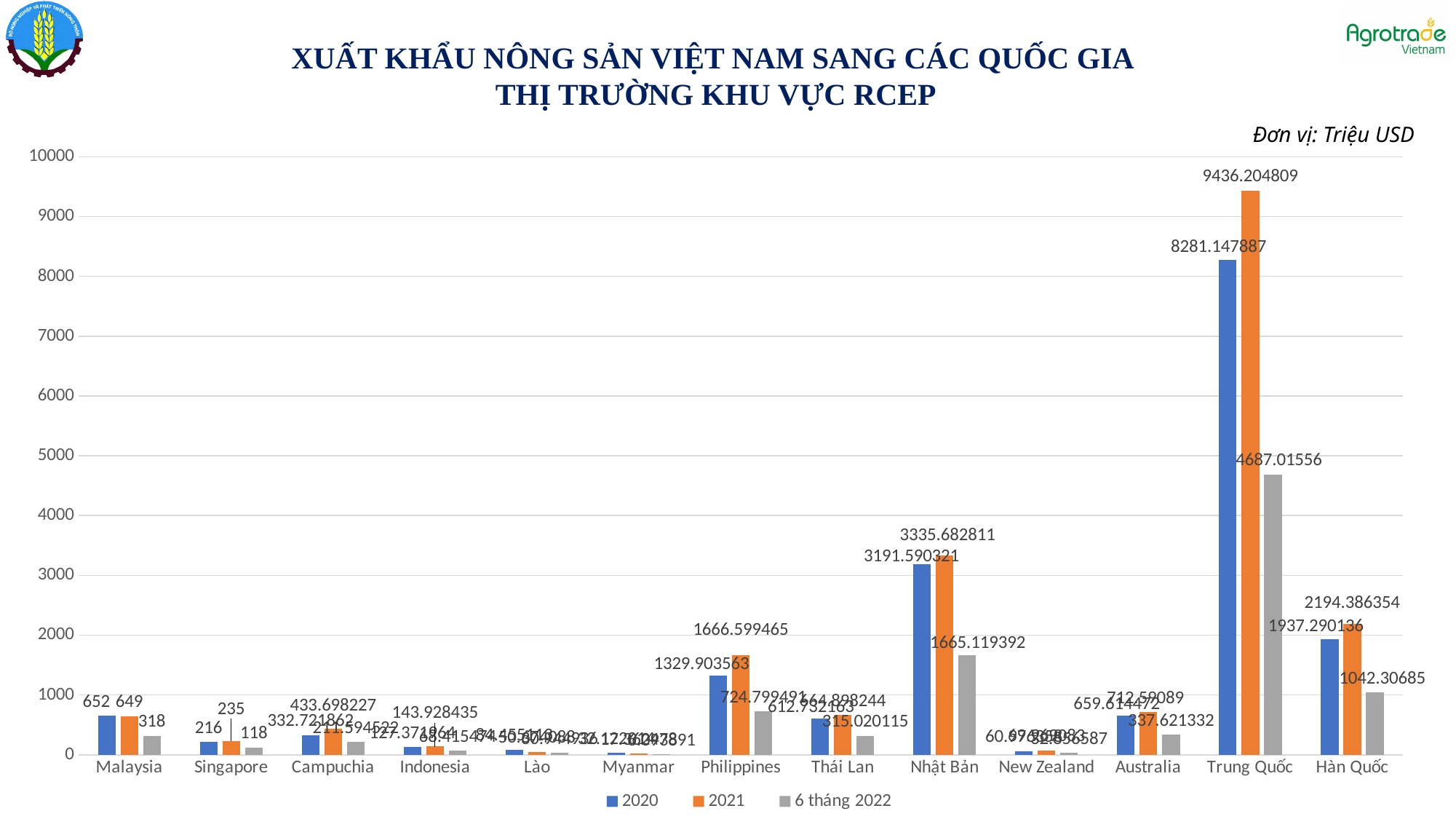
Is the 2020 value for Nhật Bản greater or less than 3000? greater What is the value for Malaysia in the 2020 series? 652 What is the value for Singapore in the 2021 series? 235 What is the value for Trung Quốc in the 2021 series? 9436.204809 What is the value for Hàn Quốc in the 2021 series? 2194.386354 How many countries are shown on the x axis? 13 What kind of chart is shown on the slide? bar chart Which is larger in the 2021 series: Hàn Quốc or Philippines? Hàn Quốc How many series does the legend list? 3 What is the difference between the 2020 and 2021 values for Malaysia? 3 Which country has the highest value in the 2021 series? Trung Quốc What is the value for Nhật Bản in the 6 tháng 2022 series? 1665.119392